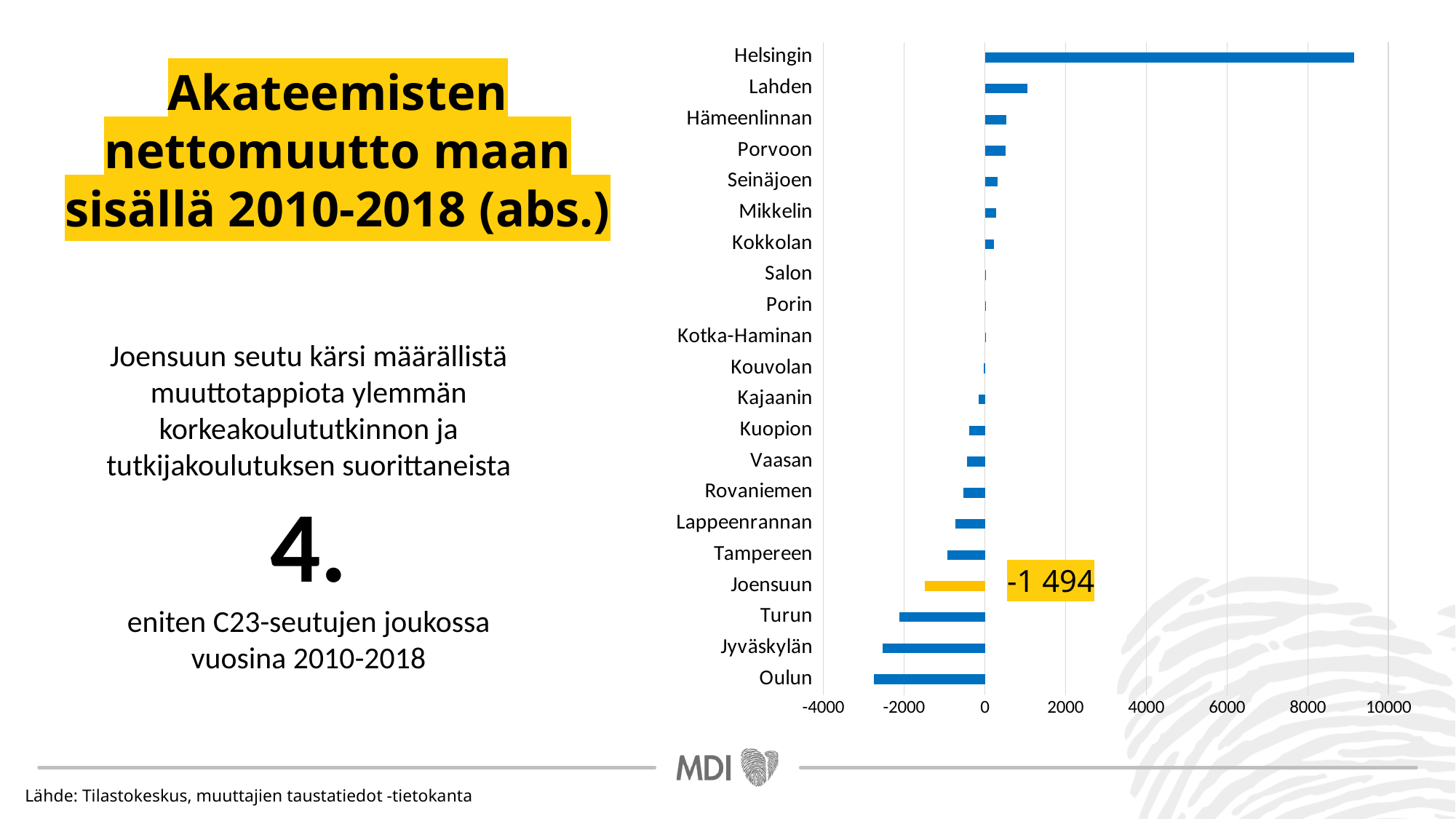
How many regions are shown in the chart? 21 What colour is the bar for Joensuun? Yellow What kind of chart is shown on the slide? Bar chart Is the value for Jyväskylän greater or less than -2000? less Is the value for Lahden greater or less than 2000? less Is the value for Helsingin greater or less than 8000? greater Which region has the highest value in the chart? Helsingin Do the values rise or fall going from the top region to the bottom region? Fall Which has the larger value, Helsingin or Lahden? Helsingin Which region has the lowest value in the chart? Oulun What is the value shown for Joensuun in the chart? -1 494 Which has the larger value, Tampereen or Joensuun? Tampereen